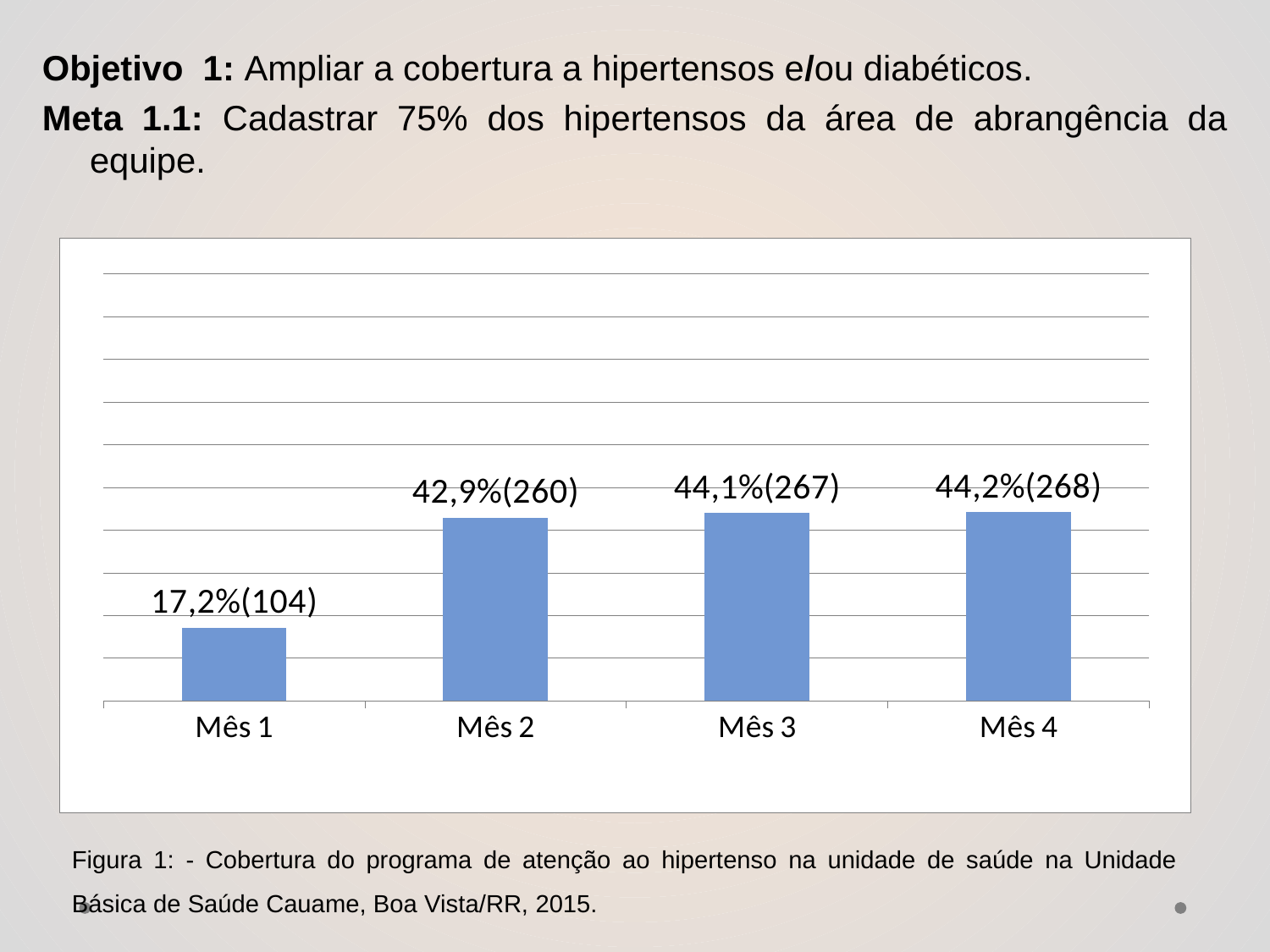
What is the data label shown for Mês 4? 44,2%(268) Which month has the lowest coverage? Mês 1 How many more patients were registered in Mês 4 (268) than in Mês 1 (104)? 164 What kind of chart is shown on the slide? Bar chart Which has the larger value, Mês 1 or Mês 2? Mês 2 How many months (categories) are plotted in the chart? 4 What coverage percentage is shown for Mês 2? 42,9% Which month has the highest coverage according to the data labels? Mês 4 What is the data label shown for Mês 1? 17,2%(104) What is the difference in percentage points between Mês 2 (42,9%) and Mês 1 (17,2%)? 25,7 How many hypertensive patients were registered in Mês 3, according to the data label? 267 Do the values rise or fall from Mês 1 to Mês 4? Rise